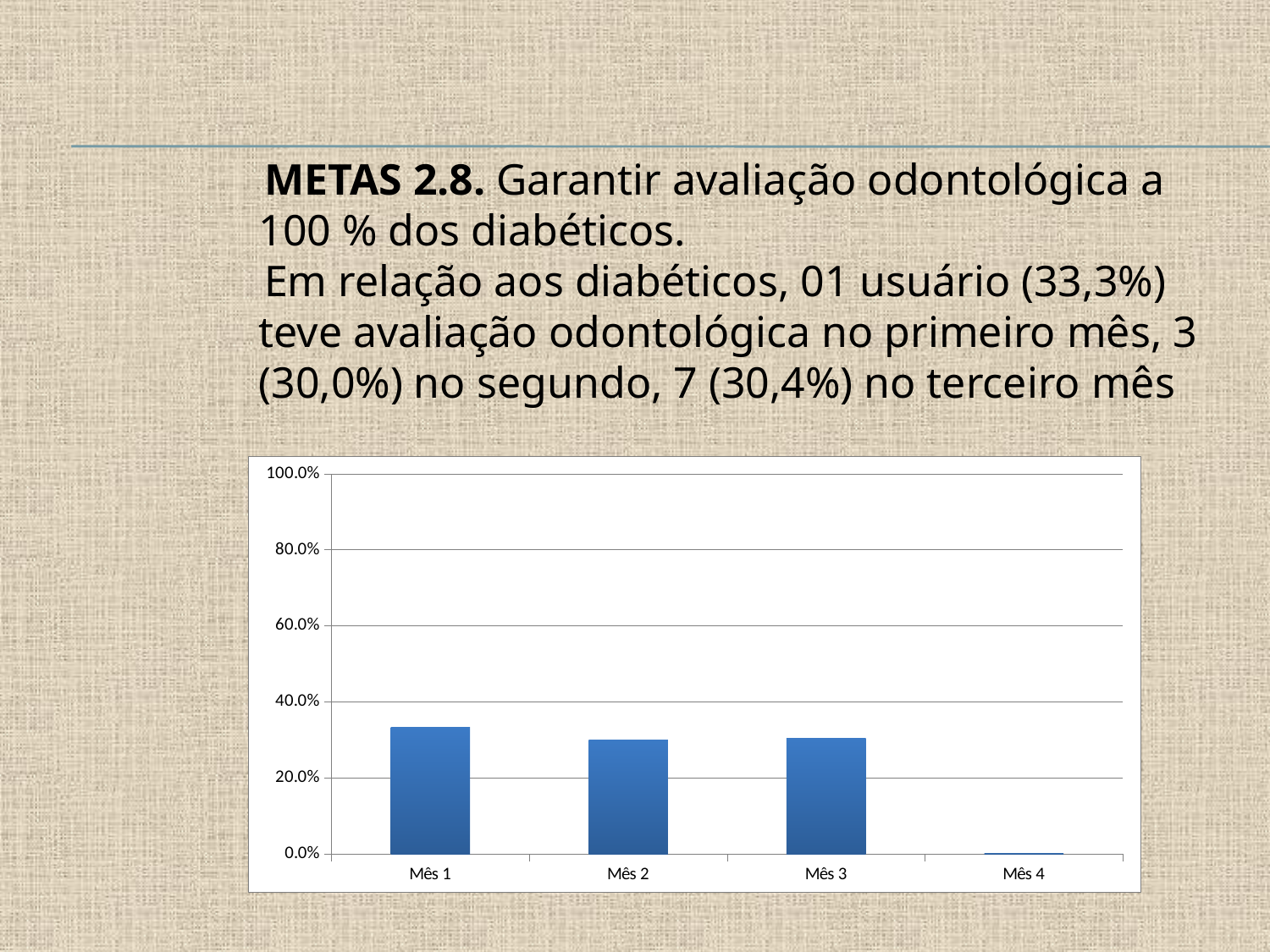
Is the value for Mês 1 greater or less than 20.0%? greater Which category has the lowest bar in the chart? Mês 4 Is the value for Mês 2 greater or less than 20.0%? greater Is the value for Mês 3 greater or less than 40.0%? less Which is larger, the value for Mês 1 or the value for Mês 2? Mês 1 Which category has the highest bar in the chart? Mês 1 What is the highest value shown on the y axis of the chart? 100.0% How many categories are shown on the x axis of the chart? 4 Which is larger, the value for Mês 3 or the value for Mês 4? Mês 3 What kind of chart is shown on the slide? bar chart